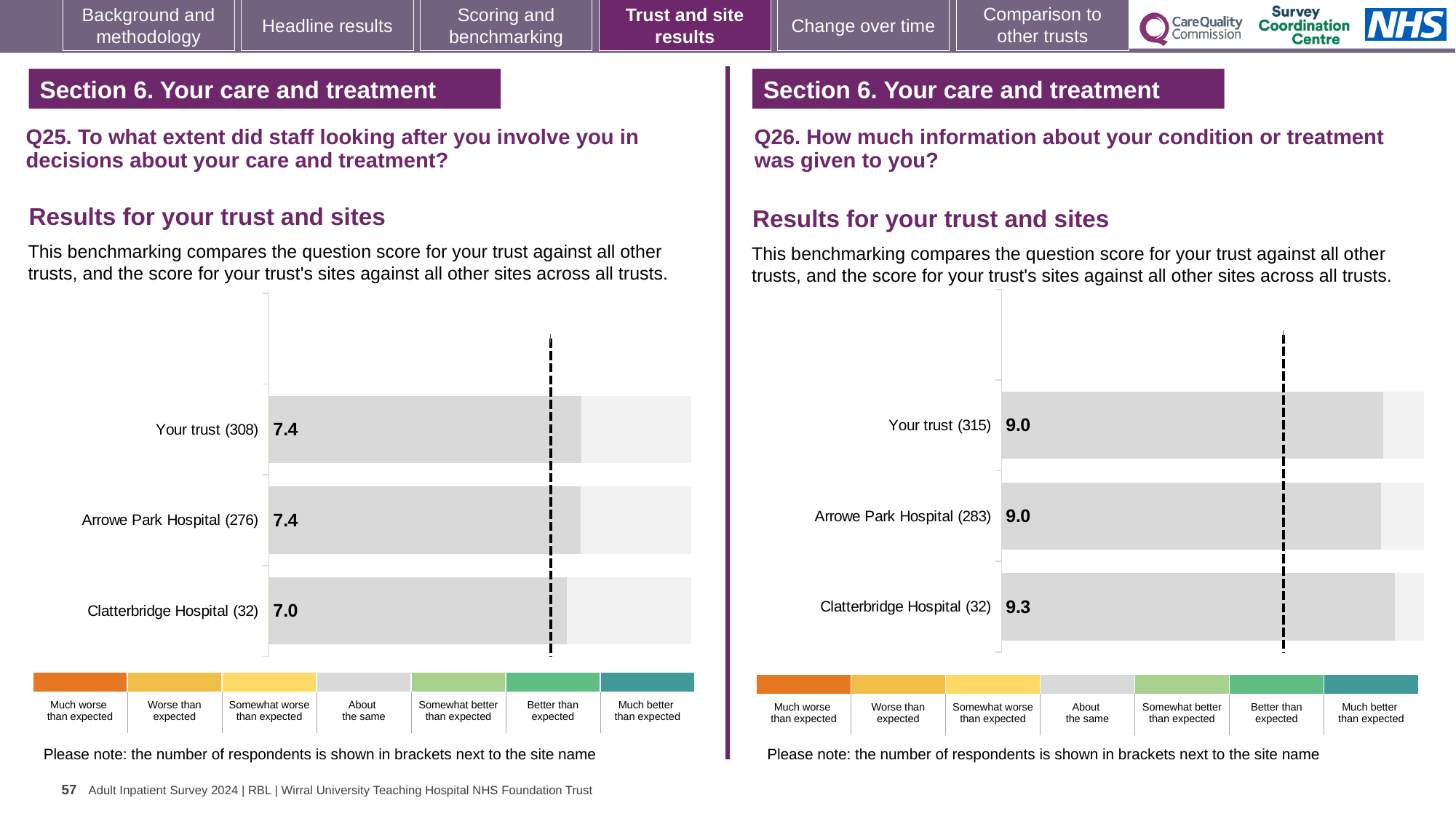
On the Q26 chart (right), what is the score for Arrowe Park Hospital (283)? 9.0 On the Q26 chart (right), which site or trust has the highest score? Clatterbridge Hospital (32) On the Q25 chart (left), what is the score for Your trust (308)? 7.4 On the Q25 chart (left), what is the score for Clatterbridge Hospital (32)? 7.0 On the Q25 chart (left), which site or trust has the lowest score? Clatterbridge Hospital (32) On the Q26 chart (right), what is the score for Clatterbridge Hospital (32)? 9.3 What type of chart is used on the Q26 chart (right)? Bar chart On the Q25 chart (left), what is the difference between the scores for Arrowe Park Hospital (276) and Clatterbridge Hospital (32)? 0.4 On the Q25 chart (left), how many bars are plotted? 3 On the Q26 chart (right), which has the larger score: Your trust (315) or Clatterbridge Hospital (32)? Clatterbridge Hospital (32) On the Q25 chart (left), how many respondents are shown in brackets for Arrowe Park Hospital? 276 On the Q26 chart (right), what is the difference between the scores for Clatterbridge Hospital (32) and Your trust (315)? 0.3